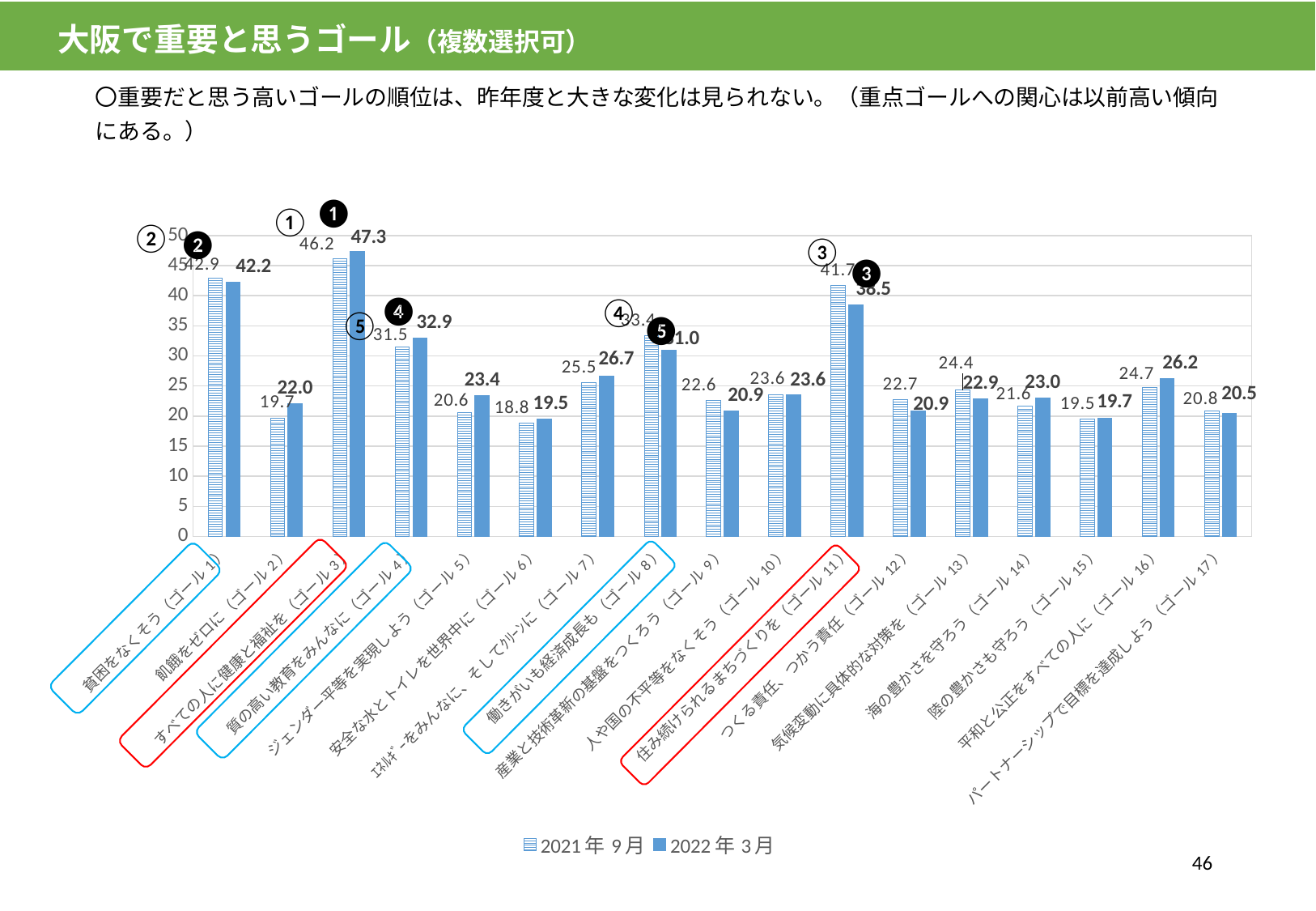
What is the value for 2021年 9月 for 貧困をなくそう（ゴール1）? 42.9 For 平和と公正をすべての人に（ゴール16）, which series has the larger value, 2021年 9月 or 2022年 3月? 2022年 3月 Which category has the lowest value for 2021年 9月? 安全な水とトイレを世界中に（ゴール6） What is the value for 2022年 3月 for すべての人に健康と福祉を（ゴール3）? 47.3 What kind of chart is shown on the slide? Bar chart How many series does the legend list? 2 What is the value for 2021年 9月 for 気候変動に具体的な対策を（ゴール13）? 24.4 Which category has the highest value for 2022年 3月? すべての人に健康と福祉を（ゴール3） What is the value for 2022年 3月 for 質の高い教育をみんなに（ゴール4）? 32.9 How many categories (goals) are shown on the x axis? 17 Is the 2022年 3月 value for 貧困をなくそう（ゴール1）greater or less than 40? greater What is the difference between the 2022年 3月 and 2021年 9月 values for 飢餓をゼロに（ゴール2）? 2.3